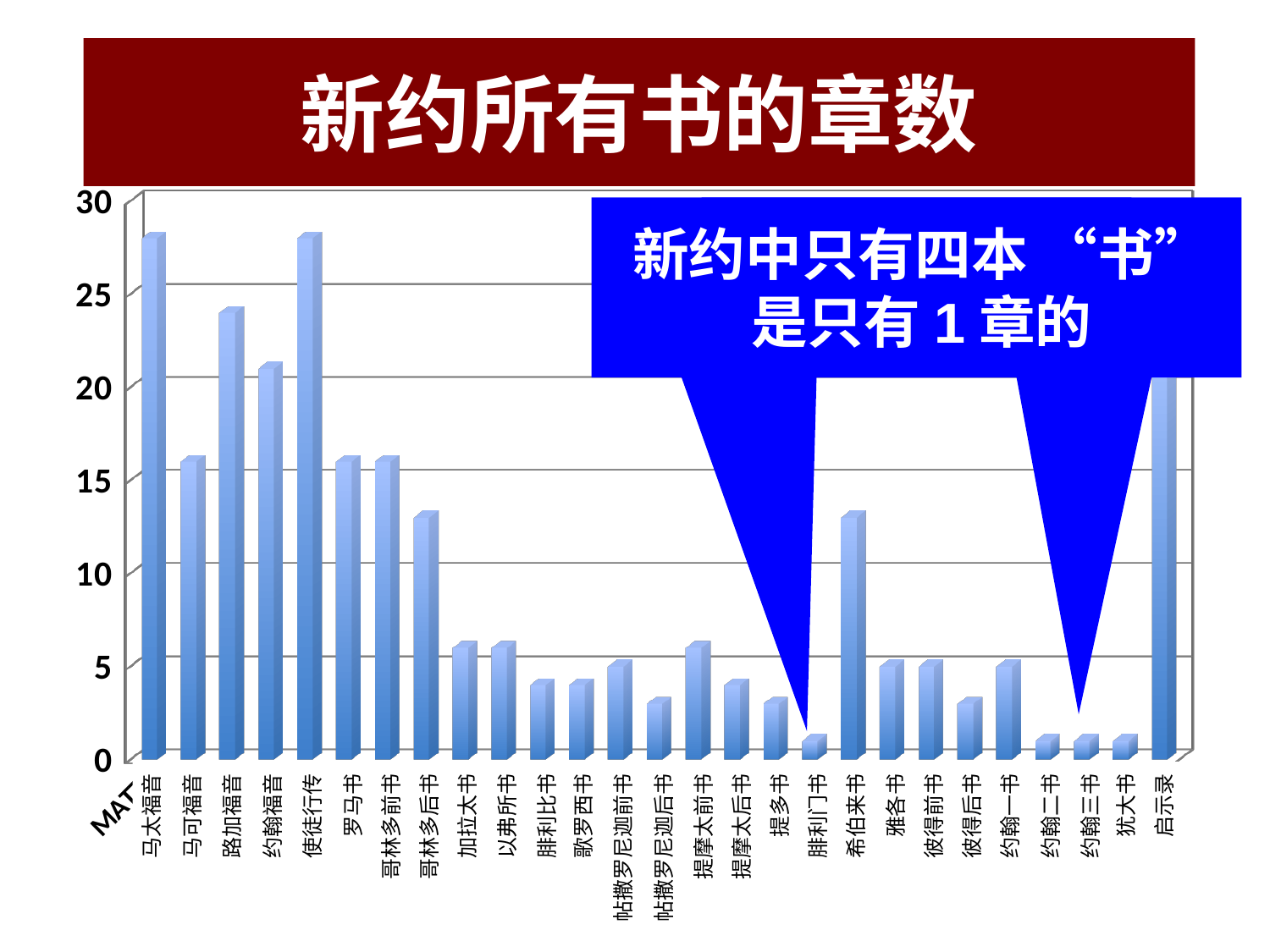
Is the value for 启示录 greater or less than 20? greater Is the value for 提多书 greater or less than 5? less What is the title of the chart? 新约所有书的章数 Is the value for 马太福音 greater or less than 25? greater What kind of chart is shown on the slide? bar chart According to the callout on the chart, how many New Testament books have only 1 chapter? 四本 (4) Which has the larger value, 路加福音 or 马可福音? 路加福音 Which has the larger value, 希伯来书 or 雅各书? 希伯来书 Which has the larger value, 启示录 or 哥林多后书? 启示录